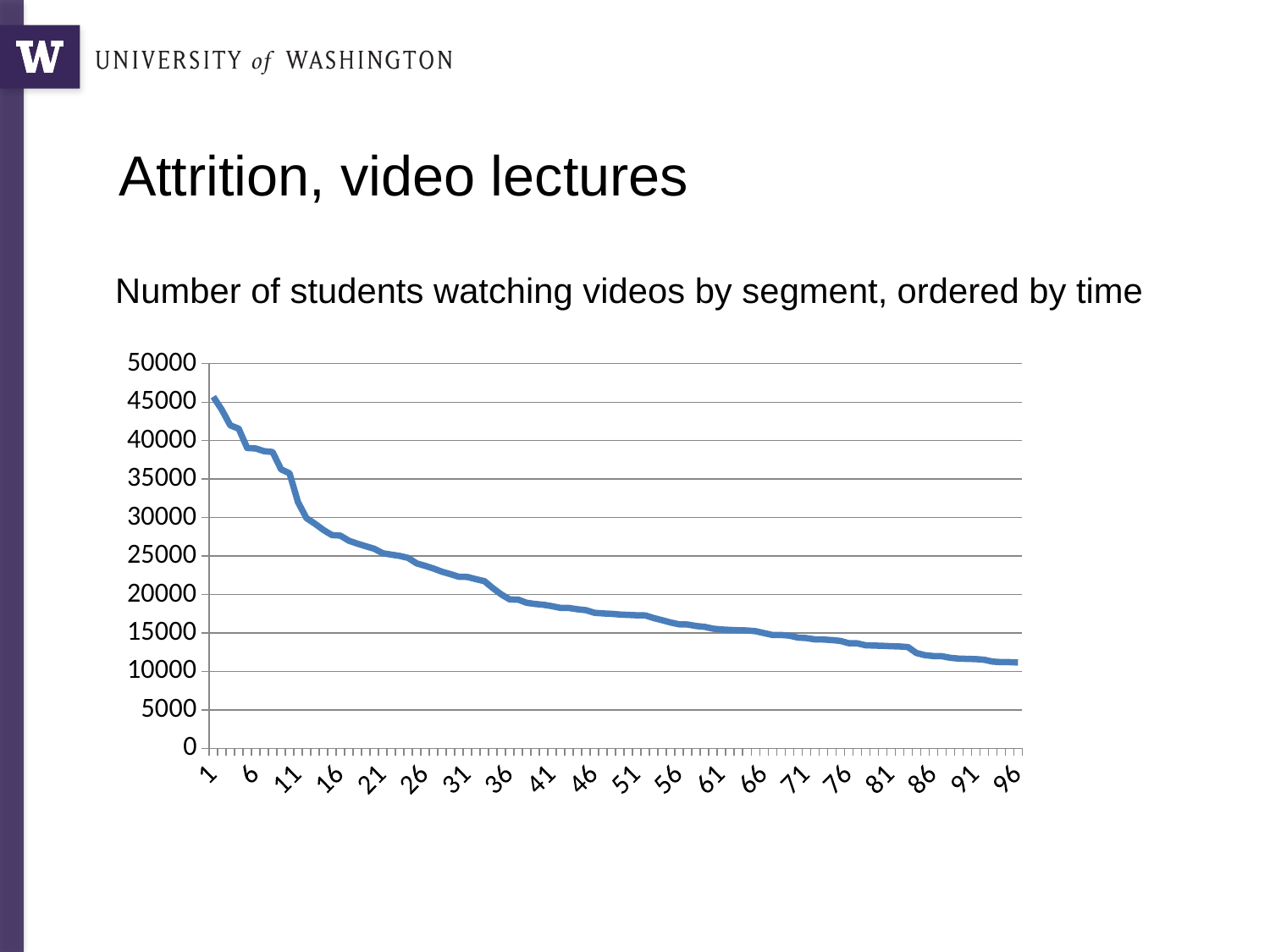
Is the value for segment 6 greater or less than 35000? greater Which segment has the lowest number of students watching? 96 Do the values rise or fall as the segment number increases along the x axis? fall What is the title of the slide containing the chart? Attrition, video lectures Is the value for segment 96 greater or less than 15000? less Which is larger, the value for segment 16 or the value for segment 61? segment 16 What kind of chart is shown on the slide? line chart Is the value for segment 51 greater or less than 20000? less What is the highest value shown on the y axis? 50000 Which segment has the highest number of students watching? 1